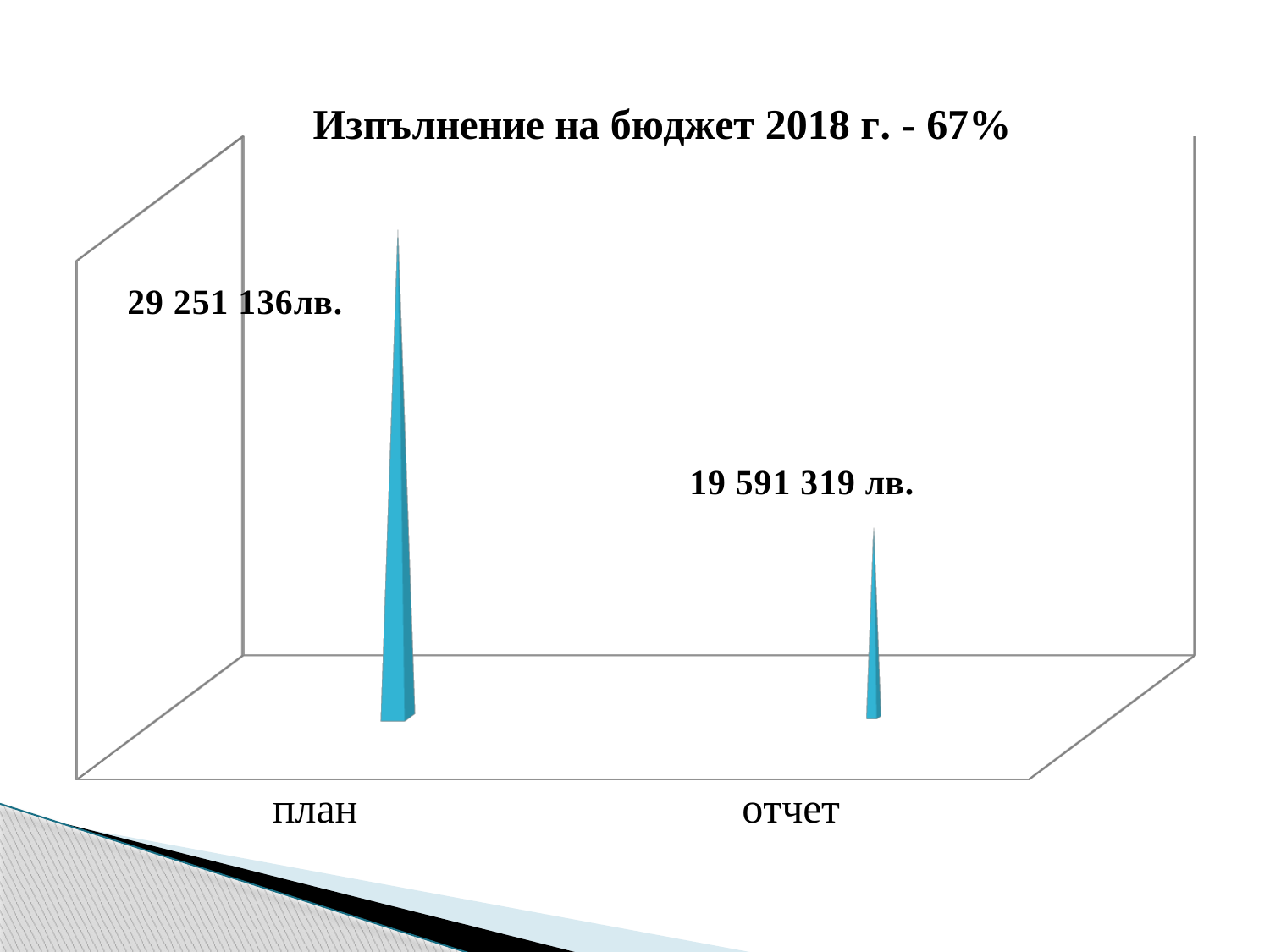
What is the difference between the value for план and the value for отчет? 9 659 817 лв. What is the value shown for план? 29 251 136лв. Which category has the lowest value? отчет Which is larger, the value for план or the value for отчет? план What is the value shown for отчет? 19 591 319 лв. What is the title of the chart? Изпълнение на бюджет 2018 г. - 67% What kind of chart is shown on the slide? bar chart What percentage of budget execution is stated in the chart title? 67% Do the values rise or fall from план to отчет? fall Which category has the highest value? план How many categories are shown on the x axis? 2